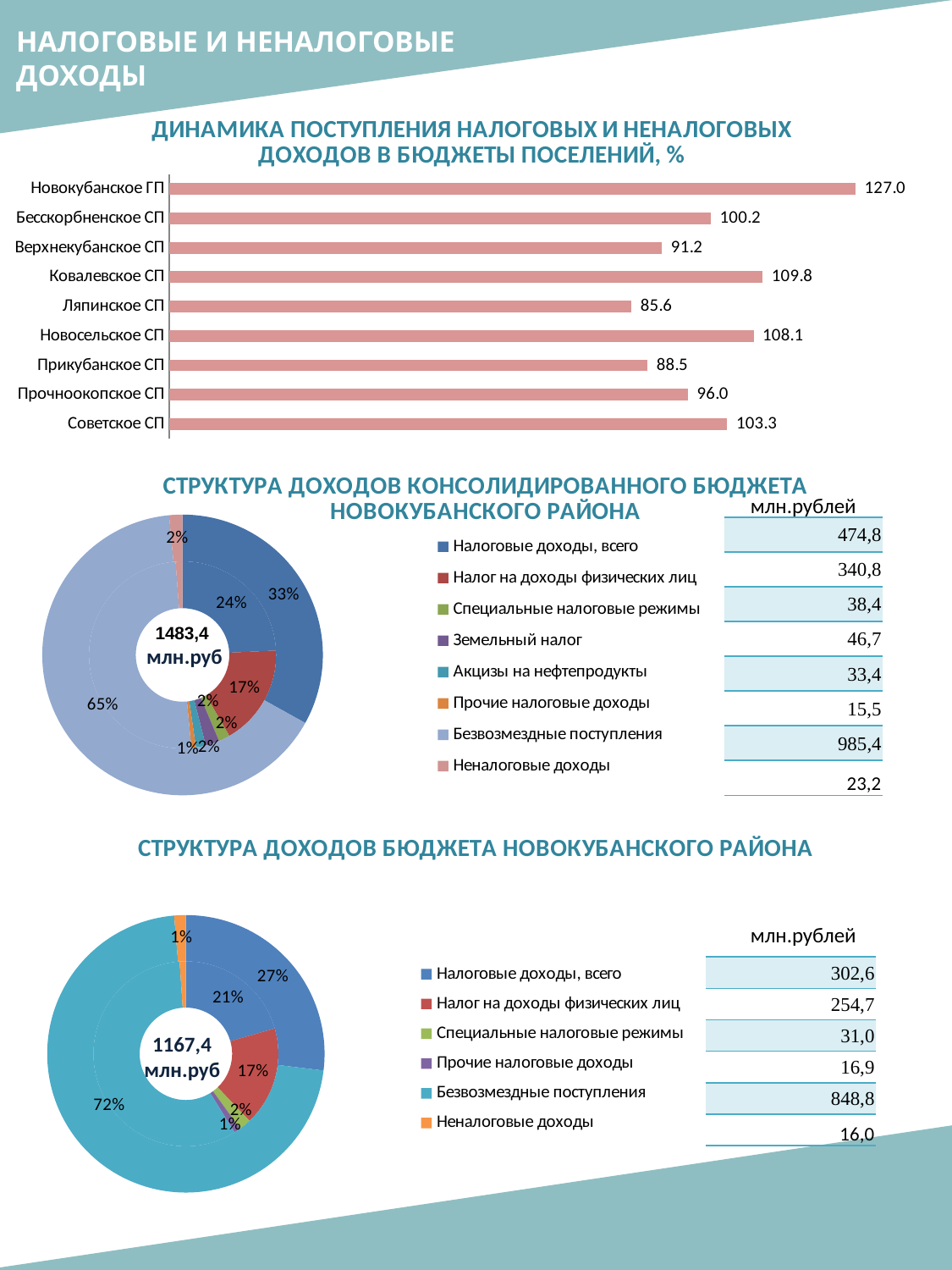
In the bar chart 'Динамика поступления налоговых и неналоговых доходов в бюджеты поселений, %', which settlement has the lowest value? Ляпинское СП In the chart 'Структура доходов бюджета Новокубанского района', what is the value in млн.рублей for Налог на доходы физических лиц? 254,7 In the chart 'Структура доходов бюджета Новокубанского района', what share of the doughnut is labelled for Безвозмездные поступления? 72% In the bar chart 'Динамика поступления налоговых и неналоговых доходов в бюджеты поселений, %', which is larger: the value for Бесскорбненское СП or for Советское СП? Советское СП How many entries does the legend list in the chart 'Структура доходов консолидированного бюджета Новокубанского района'? 8 In the chart 'Структура доходов консолидированного бюджета Новокубанского района', what is the value in млн.рублей for Безвозмездные поступления? 985,4 What total value is printed in the centre of the doughnut chart 'Структура доходов бюджета Новокубанского района'? 1167,4 млн.руб In the bar chart 'Динамика поступления налоговых и неналоговых доходов в бюджеты поселений, %', what is the value for Ковалевское СП? 109.8 In the bar chart 'Динамика поступления налоговых и неналоговых доходов в бюджеты поселений, %', what is the difference between the values for Новокубанское ГП and Ляпинское СП? 41.4 What type of chart is the top chart 'Динамика поступления налоговых и неналоговых доходов в бюджеты поселений, %'? bar chart In the bar chart 'Динамика поступления налоговых и неналоговых доходов в бюджеты поселений, %', which settlement has the highest value? Новокубанское ГП How many settlements are shown in the bar chart 'Динамика поступления налоговых и неналоговых доходов в бюджеты поселений, %'? 9